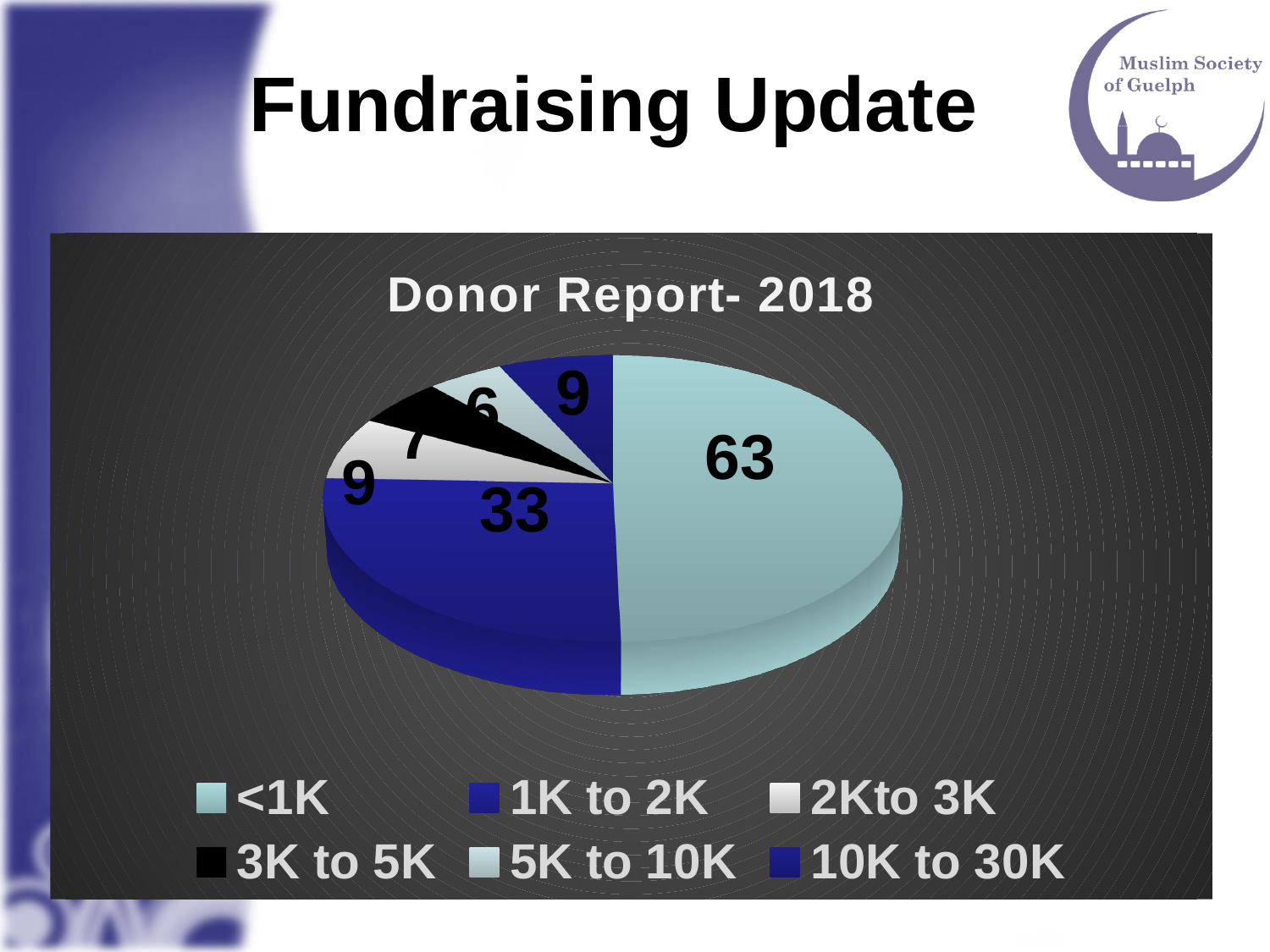
What is the total of all the values shown on the pie chart? 127 Which category has the largest slice of the pie? <1K What is the difference between the values for <1K and 1K to 2K? 30 What is the title of the chart? Donor Report- 2018 What is the value for the 5K to 10K category? 6 How many categories does the pie chart have? 6 What is the value for the 1K to 2K category? 33 What is the value for the <1K category? 63 What is the value for the 10K to 30K category? 9 Which category has the smallest slice of the pie? 5K to 10K What kind of chart is shown on the slide? Pie chart Which is larger, the value for <1K or the value for 1K to 2K? <1K